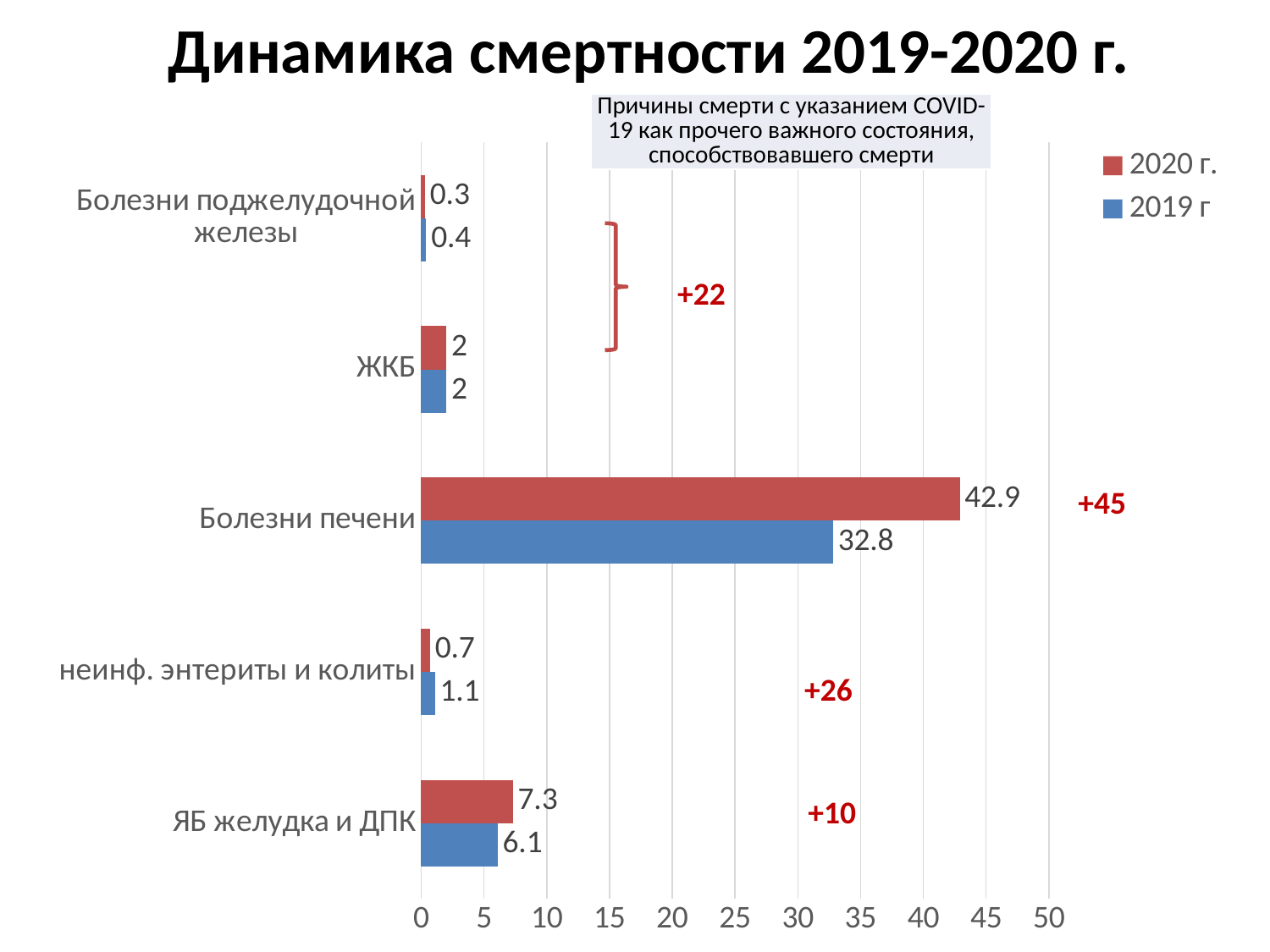
How many series does the legend list? 2 What is the value for ЯБ желудка и ДПК in the 2020 г. series? 7.3 What kind of chart is shown on the slide? Bar chart What is the value for неинф. энтериты и колиты in the 2019 г series? 1.1 Which category has the lowest value in the 2019 г series? Болезни поджелудочной железы How many categories are shown on the chart? 5 What is the value for Болезни печени in the 2019 г series? 32.8 Which category has the highest value in the 2020 г. series? Болезни печени What is the value for Болезни печени in the 2020 г. series? 42.9 What is the difference between the 2020 г. and 2019 г values for Болезни печени? 10.1 What is the value for Болезни поджелудочной железы in the 2020 г. series? 0.3 Which is larger for ЯБ желудка и ДПК: the 2020 г. value or the 2019 г value? 2020 г.